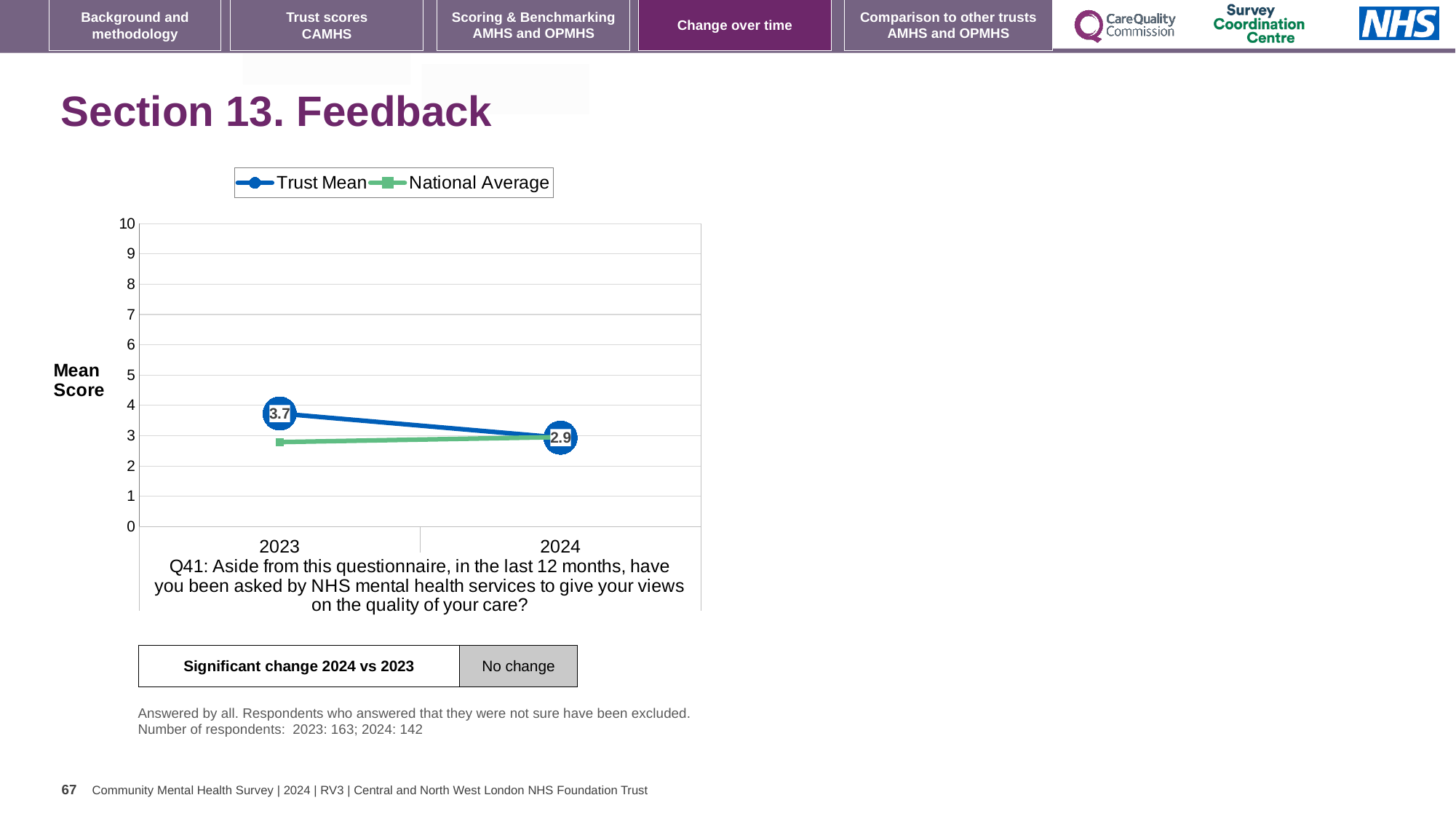
In which year is the Trust Mean score highest? 2023 How many series does the chart legend list? 2 What is the difference between the Trust Mean score in 2023 and in 2024? 0.8 What is the Trust Mean score for 2024? 2.9 In which year is the Trust Mean score lowest? 2024 In 2023, which is larger: the Trust Mean or the National Average? Trust Mean Is the National Average value for 2023 greater or less than 5? less How many years are plotted on the x axis of the chart? 2 Does the Trust Mean rise or fall from 2023 to 2024? fall What is the Trust Mean score for 2023? 3.7 What is the label of the y axis of the chart? Mean Score What kind of chart is shown on the slide? line chart